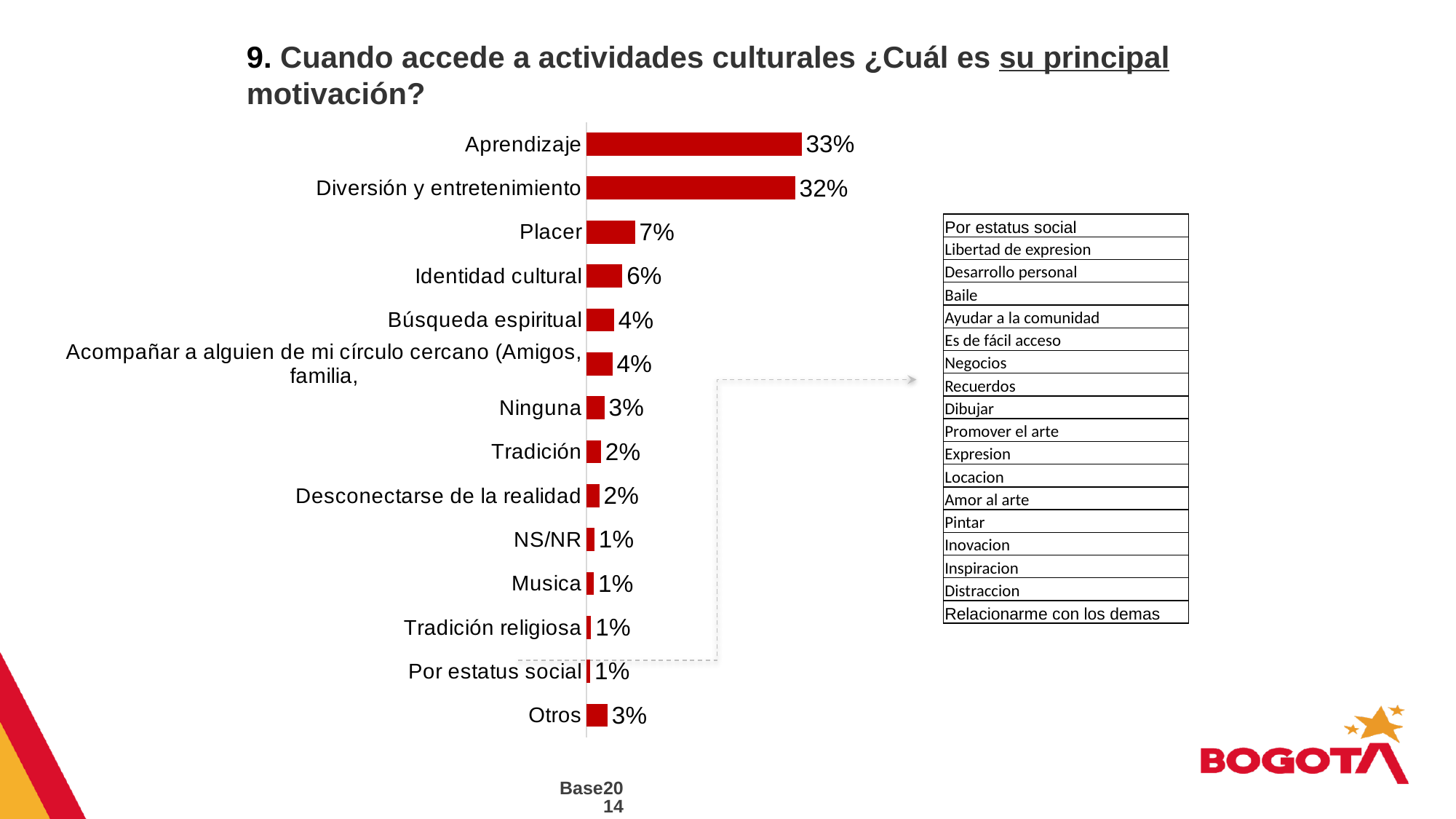
How many categories are shown in the chart? 14 What is the value for Otros? 3% What is the value for Diversión y entretenimiento? 32% What is the value for Placer? 7% What colour are the bars in the chart? red Which category has the highest value? Aprendizaje What is the value for Aprendizaje? 33% What is the difference between the values for Placer and Identidad cultural? 1% What kind of chart is shown on the slide? bar chart Which is larger, the value for Placer or the value for Búsqueda espiritual? Placer What is the value for Identidad cultural? 6% What is the difference between the values for Aprendizaje and Diversión y entretenimiento? 1%